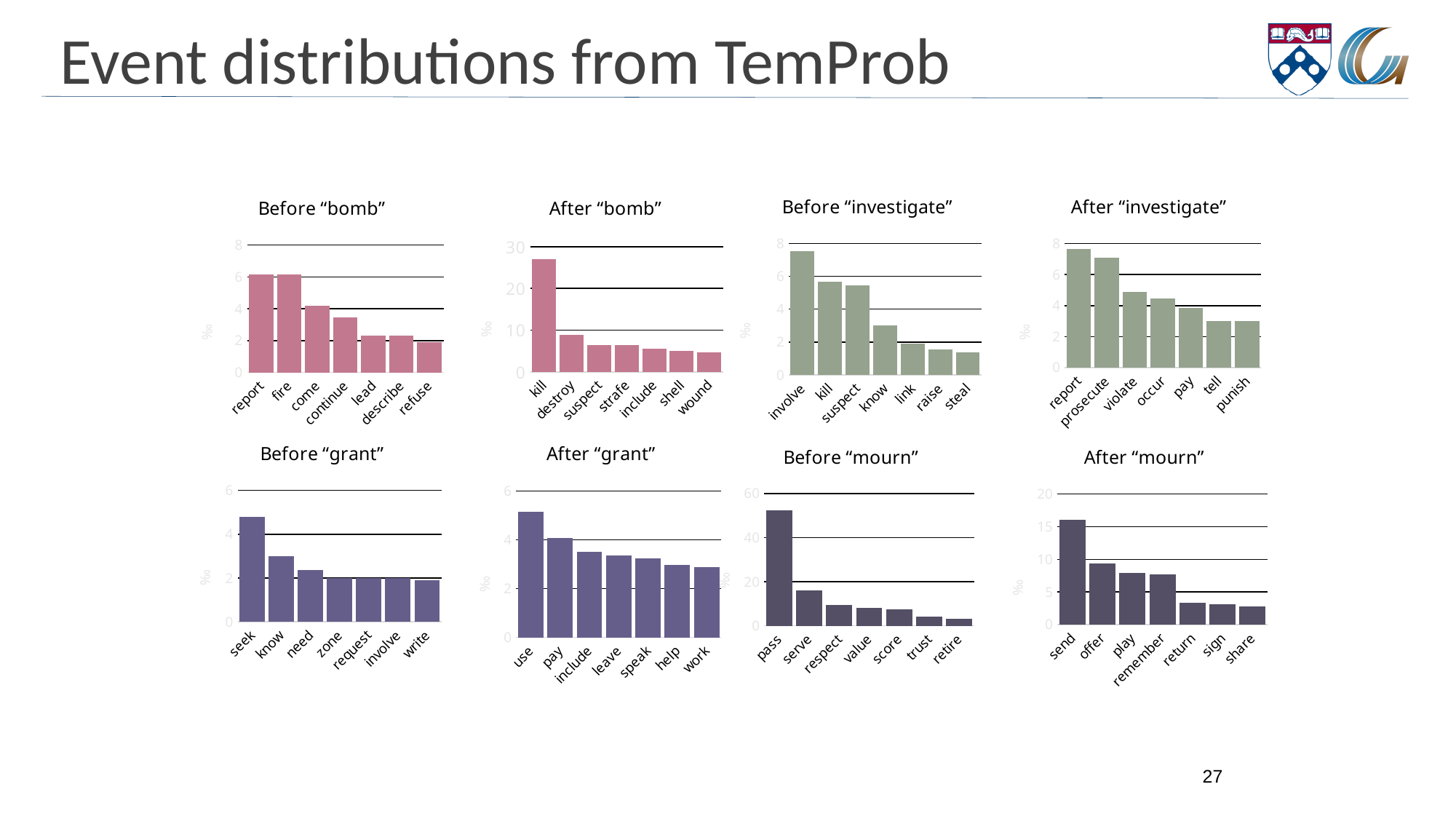
In the After "bomb" chart, which category has the highest value? kill In the Before "investigate" chart, is the value for involve greater or less than 6? greater In the Before "grant" chart, is the value for seek greater or less than 4? greater In the After "investigate" chart, which is larger, the value for violate or the value for pay? violate In the After "grant" chart, do the values rise or fall from left to right along the x axis? fall In the After "bomb" chart, is the value for kill greater or less than 20? greater What kind of chart is the Before "bomb" chart? bar chart In the After "mourn" chart, which is larger, the value for offer or the value for play? offer How many categories are shown in the After "bomb" chart? 7 In the Before "grant" chart, which category has the highest value? seek In the Before "investigate" chart, which category has the highest value? involve